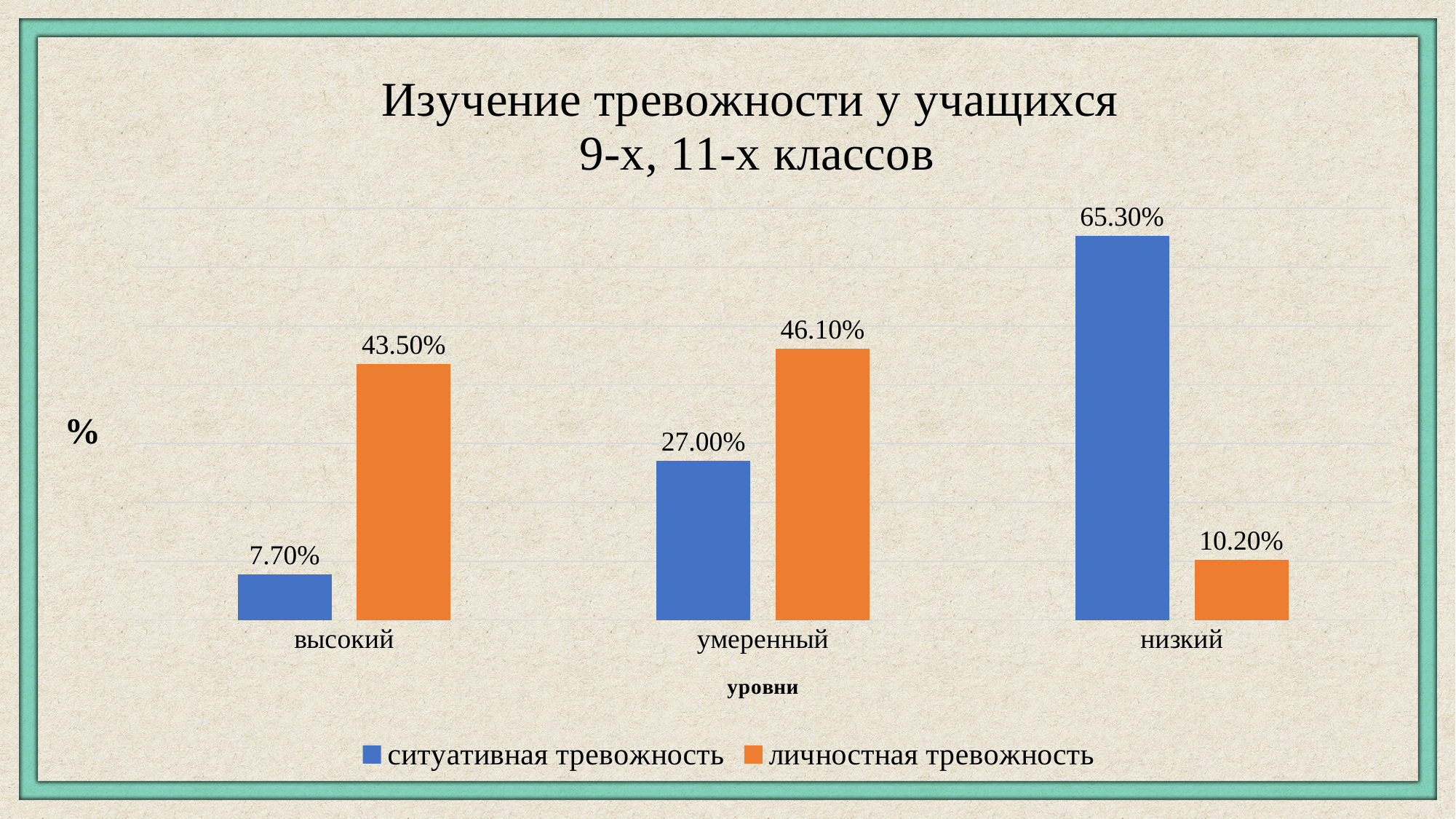
For the умеренный level, which is larger: ситуативная тревожность or личностная тревожность? личностная тревожность Which level has the lowest value for личностная тревожность? низкий Which level has the highest value for ситуативная тревожность? низкий How many series does the legend list? 2 How many levels are shown on the x axis? 3 What is the value of личностная тревожность for the умеренный level? 46.10% What is the value of ситуативная тревожность for the высокий level? 7.70% What kind of chart is shown on the slide? bar chart What is the value of личностная тревожность for the низкий level? 10.20% What is the difference between личностная тревожность and ситуативная тревожность for the высокий level? 35.80% What is the value of ситуативная тревожность for the низкий level? 65.30% What is the label of the x axis? уровни